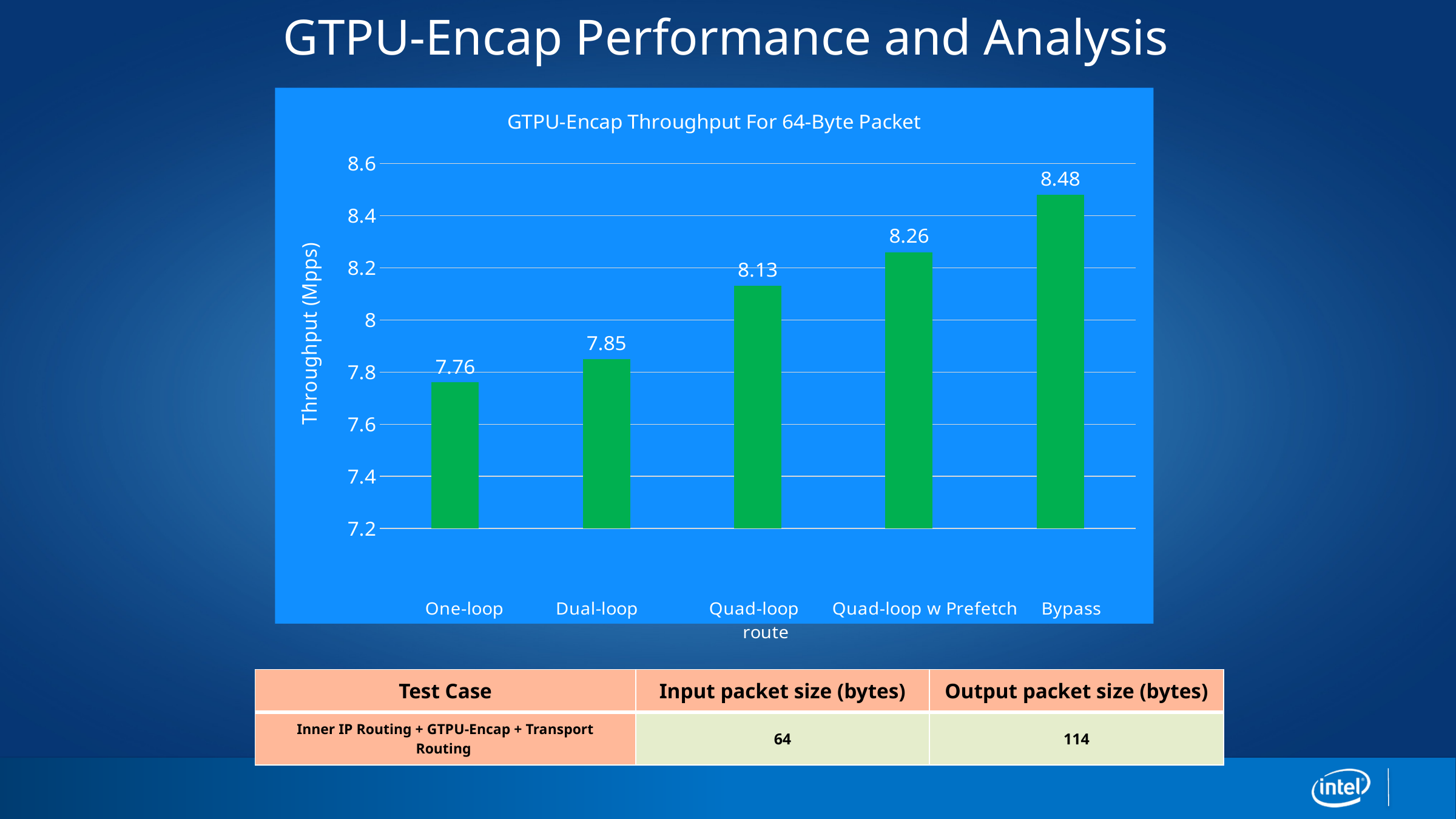
Which category has the highest throughput? Bypass Do the throughput values rise or fall from left to right along the x axis? rise Which has a higher throughput, Dual-loop or Quad-loop w Prefetch? Quad-loop w Prefetch Which category has the lowest throughput? One-loop What is the throughput for One-loop? 7.76 What is the throughput for Bypass? 8.48 What is the difference in throughput between Quad-loop route and Dual-loop? 0.28 Is the value for Quad-loop route greater or less than 8? greater How many categories are shown on the x axis? 5 What kind of chart is shown? bar chart What is the difference in throughput between Bypass and One-loop? 0.72 What is the throughput for Quad-loop w Prefetch? 8.26